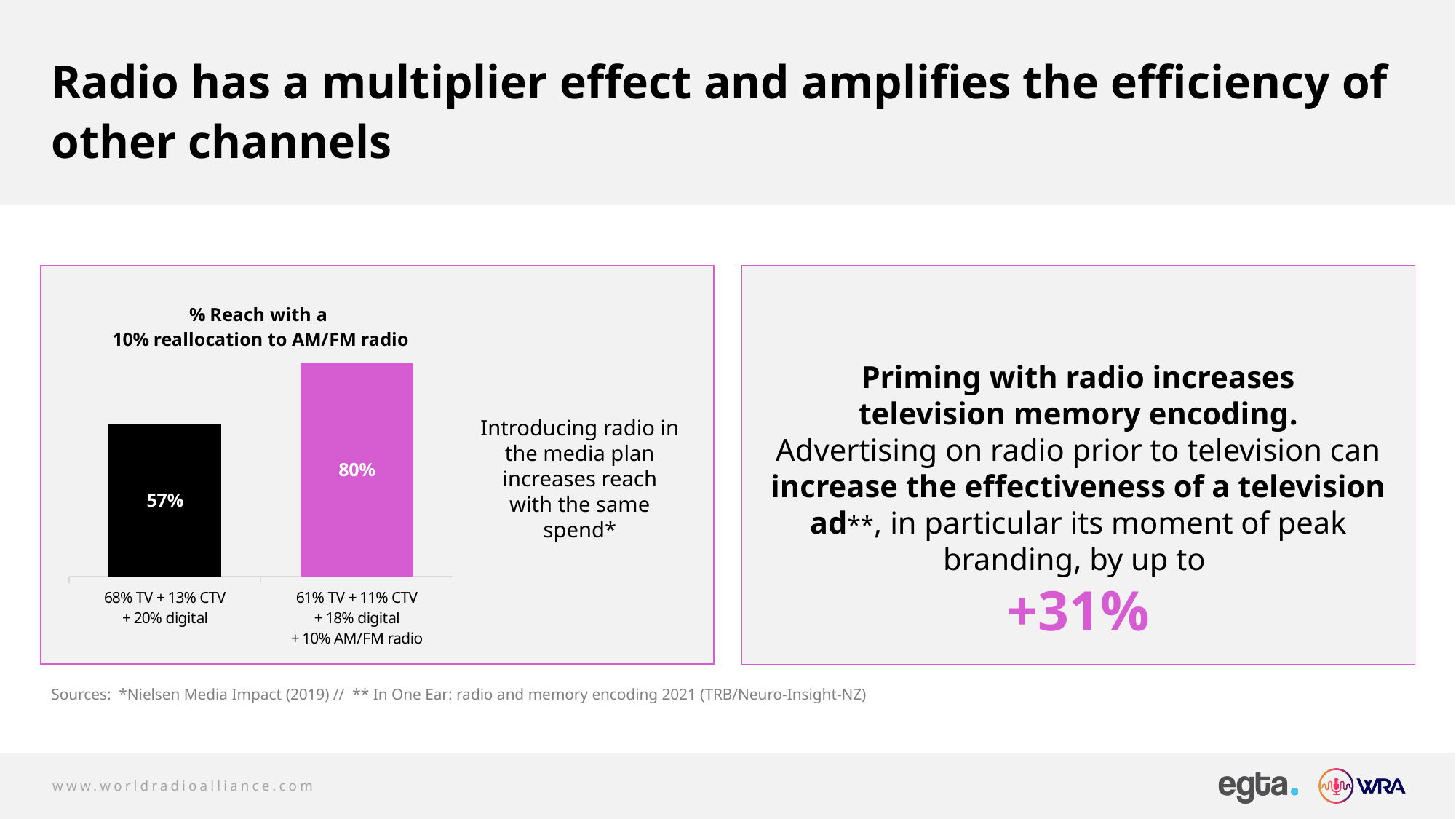
What is the difference in reach between the mix with 10% AM/FM radio and the mix without radio? 23% How many bars are shown in the chart? 2 Do the reach values rise or fall from the left bar to the right bar? rise What is the reach value for the media mix of 68% TV + 13% CTV + 20% digital? 57% What is the reach value for the media mix of 61% TV + 11% CTV + 18% digital + 10% AM/FM radio? 80% What is the title of the chart? % Reach with a 10% reallocation to AM/FM radio Is the reach for the mix with 10% AM/FM radio larger or smaller than the reach for the mix without radio? larger What type of chart is shown on the slide? bar chart Which media mix has the lower reach? 68% TV + 13% CTV + 20% digital Which media mix has the higher reach? 61% TV + 11% CTV + 18% digital + 10% AM/FM radio What colour is the bar for the media mix that includes 10% AM/FM radio? pink